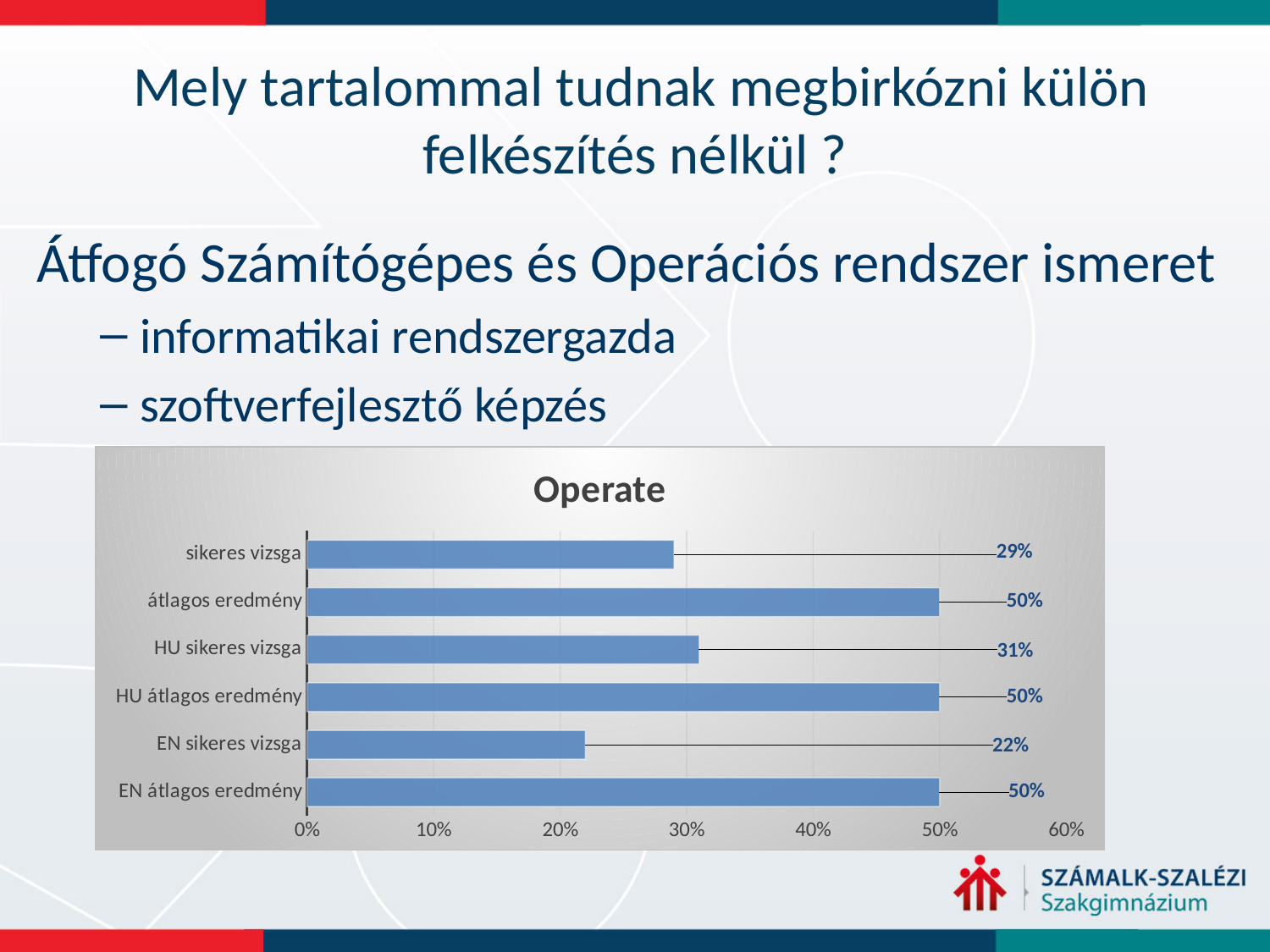
What is the value for 'EN sikeres vizsga' in the Operate chart? 22% Which is larger in the Operate chart, 'HU sikeres vizsga' or 'sikeres vizsga'? HU sikeres vizsga What is the value for 'EN átlagos eredmény' in the Operate chart? 50% How many categories are shown in the Operate chart? 6 Which category has the lowest value in the Operate chart? EN sikeres vizsga What is the difference between 'HU sikeres vizsga' and 'EN sikeres vizsga' in the Operate chart? 9% What is the value for 'HU sikeres vizsga' in the Operate chart? 31% What is the title of the chart on the slide? Operate Is the value for 'EN sikeres vizsga' greater or less than 30%? less What is the difference between 'átlagos eredmény' and 'sikeres vizsga' in the Operate chart? 21% What is the value for 'sikeres vizsga' in the Operate chart? 29% What kind of chart is shown on the slide? bar chart